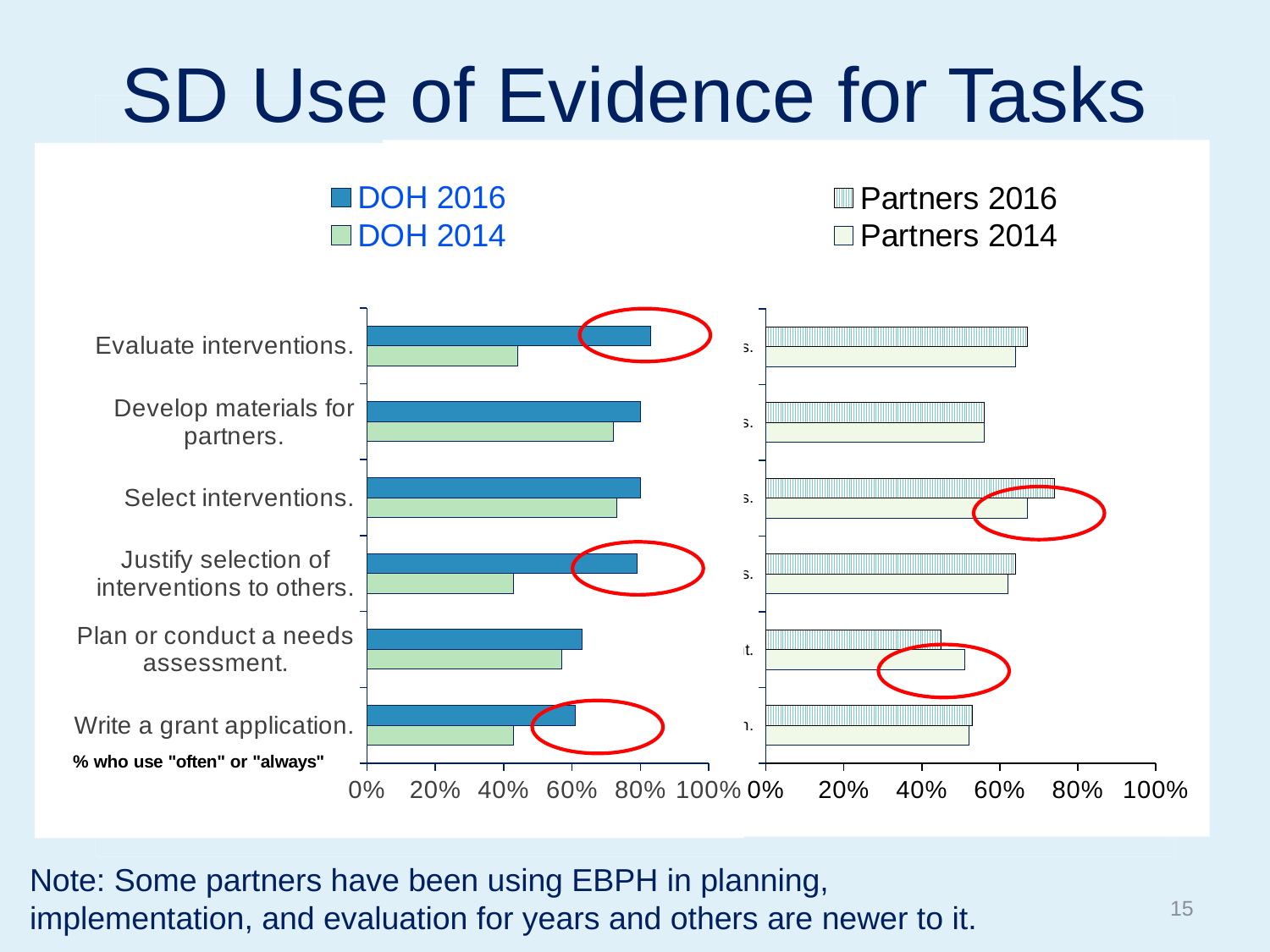
What is the title of the slide? SD Use of Evidence for Tasks On the left chart (DOH), is the DOH 2016 value for 'Evaluate interventions.' greater or less than 60%? greater How many series does the legend list in total across the slide? 4 On the left chart (DOH), is the DOH 2014 value for 'Write a grant application.' greater or less than 60%? less How many task categories are listed on the left chart (DOH)? 6 Which two series are plotted on the right chart? Partners 2016 and Partners 2014 What kind of chart is the left chart (DOH) on the slide? bar chart On the left chart (DOH), is the DOH 2014 value for 'Evaluate interventions.' greater or less than 60%? less On the left chart (DOH), which is larger for 'Evaluate interventions.': DOH 2016 or DOH 2014? DOH 2016 On the left chart (DOH), which is larger for 'Justify selection of interventions to others.': DOH 2016 or DOH 2014? DOH 2016